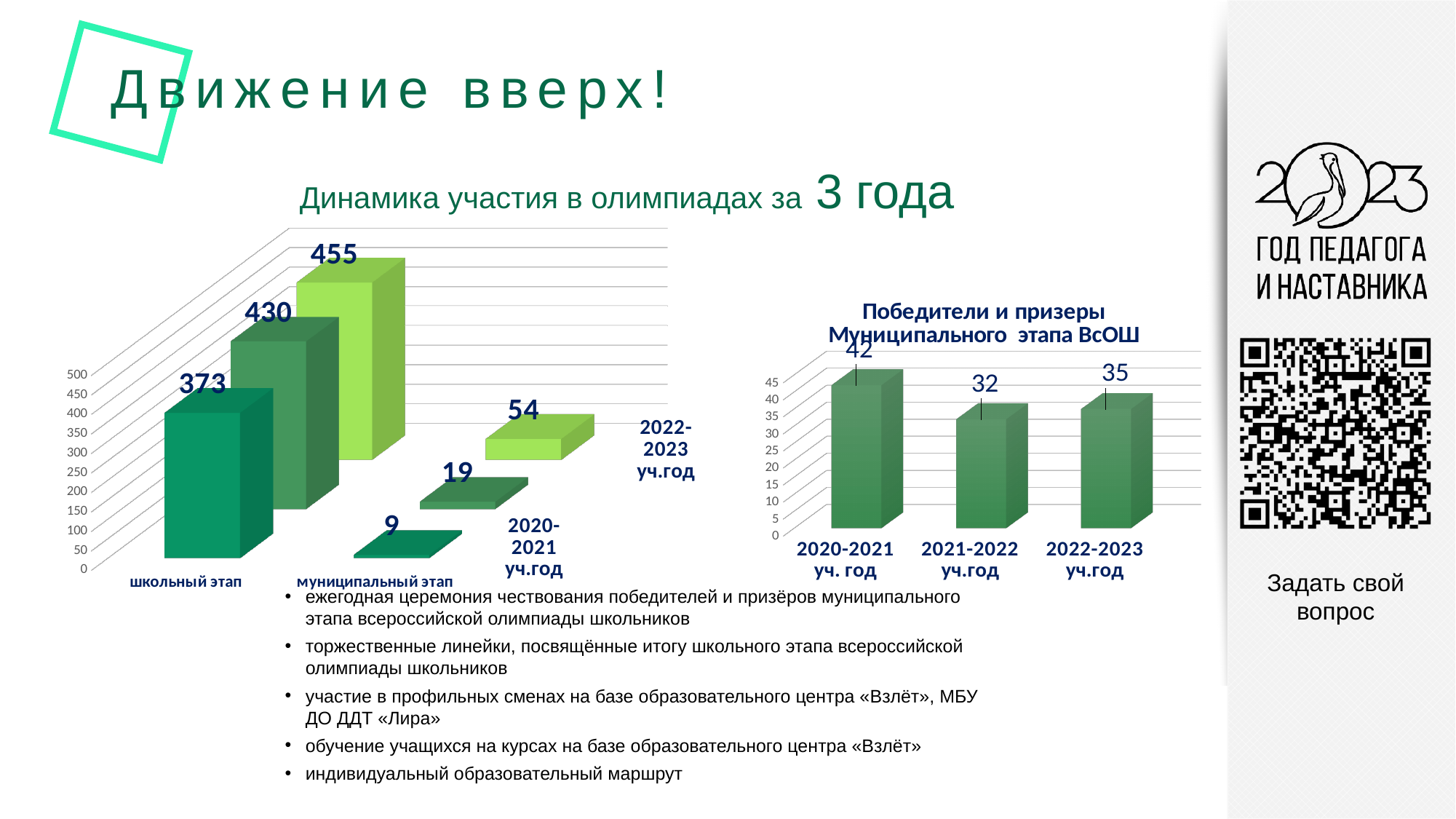
In the chart 'Победители и призеры Муниципального этапа ВсОШ', how many categories are shown on the x axis? 3 In the chart 'Победители и призеры Муниципального этапа ВсОШ', which year has the highest value? 2020-2021 уч. год In the chart 'Победители и призеры Муниципального этапа ВсОШ', which year has the lowest value? 2021-2022 уч.год In the chart 'Победители и призеры Муниципального этапа ВсОШ', what is the value for 2020-2021 уч. год? 42 In the chart 'Динамика участия в олимпиадах за 3 года', what is the difference between the школьный этап values for 2022-2023 уч.год and 2020-2021 уч.год? 82 In the chart 'Динамика участия в олимпиадах за 3 года', do the values for муниципальный этап rise or fall from 2020-2021 to 2022-2023? rise In the chart 'Динамика участия в олимпиадах за 3 года', what is the value for муниципальный этап in 2020-2021 уч.год? 9 What kind of chart is 'Победители и призеры Муниципального этапа ВсОШ'? bar chart In the chart 'Динамика участия в олимпиадах за 3 года', what is the value for школьный этап in 2022-2023 уч.год? 455 In the chart 'Победители и призеры Муниципального этапа ВсОШ', what is the value for 2022-2023 уч.год? 35 In the chart 'Победители и призеры Муниципального этапа ВсОШ', what is the difference between the values for 2020-2021 and 2021-2022? 10 In the chart 'Динамика участия в олимпиадах за 3 года', which is larger: the муниципальный этап value for 2022-2023 уч.год or for 2020-2021 уч.год? 2022-2023 уч.год